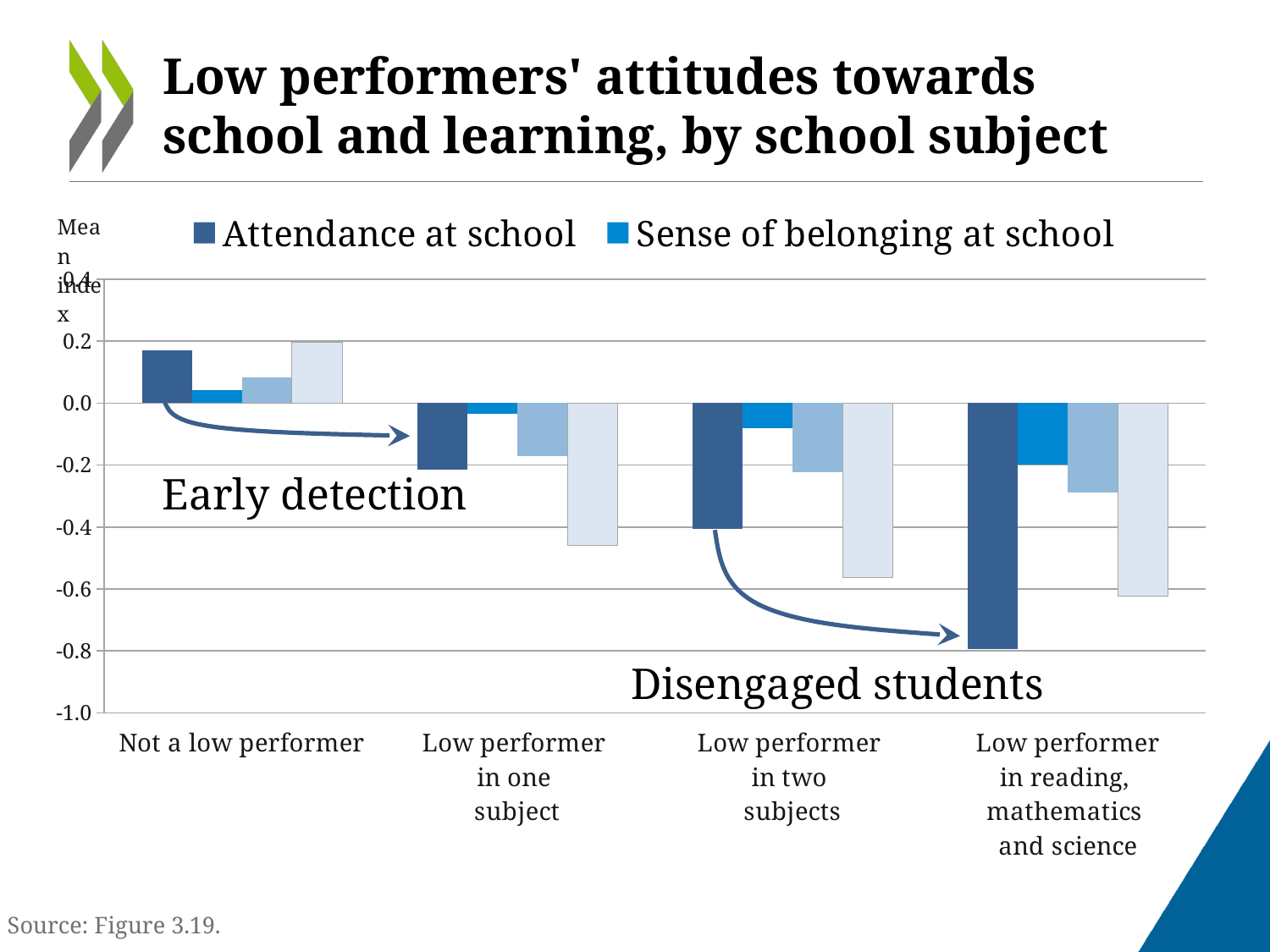
How many categories are shown along the x axis? 4 Which category has the lowest value for Attendance at school? Low performer in reading, mathematics and science Which category has the highest value for Attendance at school? Not a low performer How many series does the legend list? 2 Is the Sense of belonging at school value for Low performer in two subjects greater or less than -0.2? greater Do the Attendance at school values rise or fall moving from left to right along the x axis? fall Which category has the lowest value for Sense of belonging at school? Low performer in reading, mathematics and science Is the Attendance at school value for Low performer in reading, mathematics and science greater or less than -0.6? less For Low performer in two subjects, which is larger: Attendance at school or Sense of belonging at school? Sense of belonging at school What kind of chart is shown on the slide? bar chart What are the two series named in the legend? Attendance at school; Sense of belonging at school Is the Attendance at school value for Not a low performer greater or less than 0.0? greater